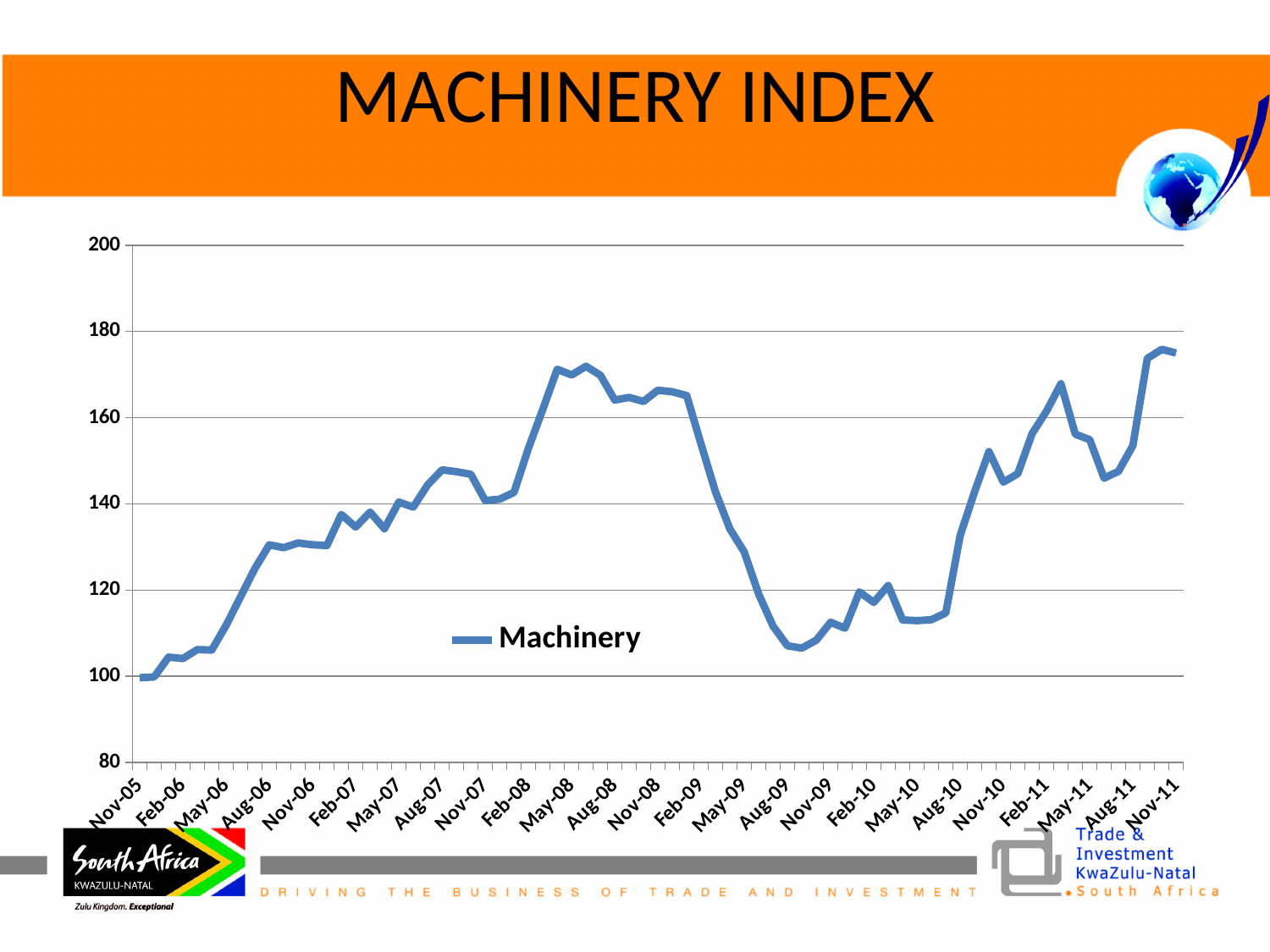
Which is larger, the value for Aug-08 or the value for Aug-09? Aug-08 Is the value for Nov-09 greater or less than 120? less Which month has the lowest value on the chart? Nov-05 Does the Machinery index rise or fall between Feb-09 and Aug-09? fall Is the value for Aug-06 greater or less than 120? greater What kind of chart is shown on the slide? line chart Is the value for May-08 greater or less than 160? greater What is the title of the chart? MACHINERY INDEX How many series does the legend list? 1 Which month has the highest value on the chart? Oct-11 What is the name of the series shown in the legend? Machinery